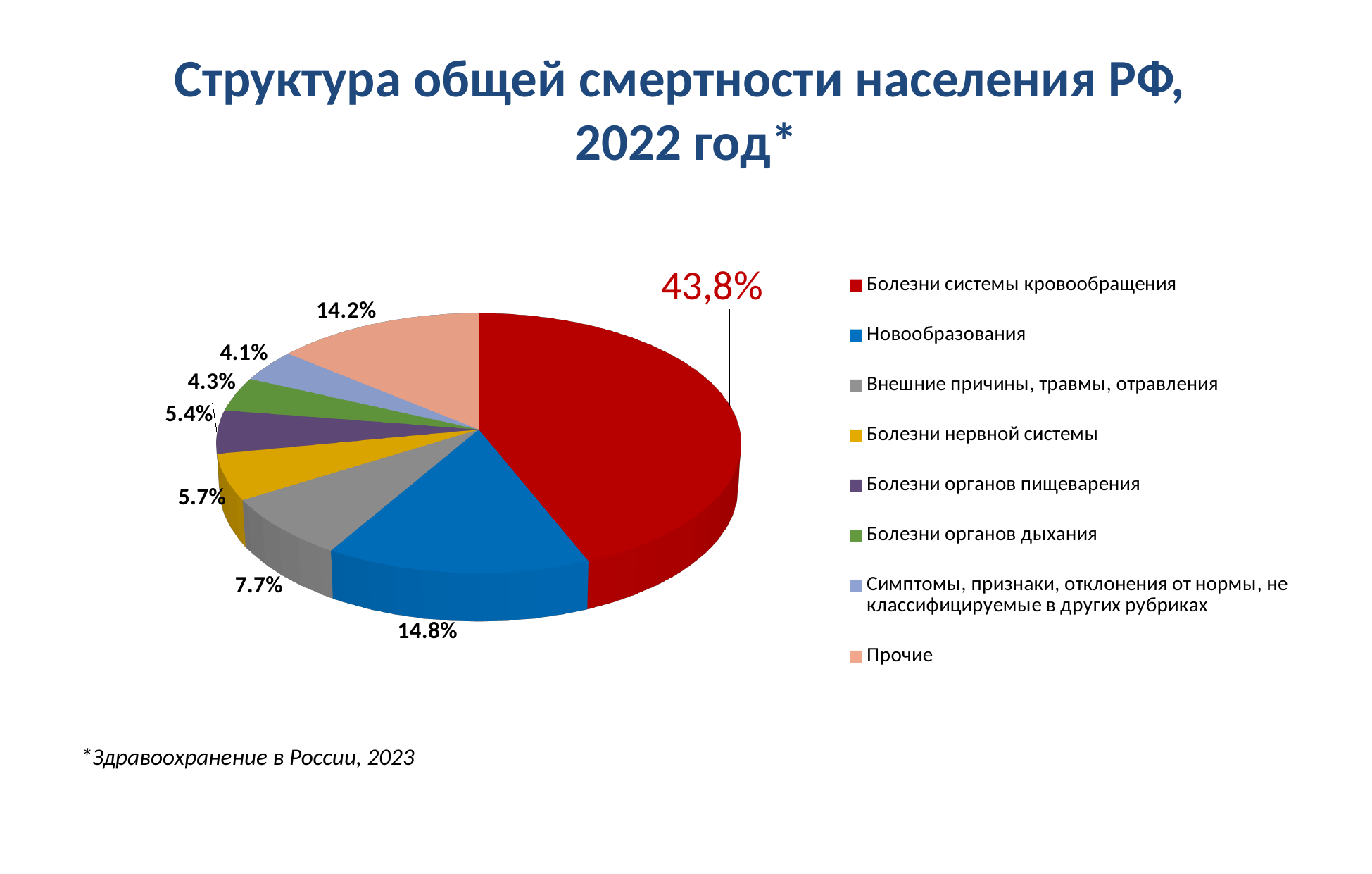
What is the value for Болезни органов дыхания? 4.3% What share of total mortality is attributed to Болезни системы кровообращения? 43,8% How many categories does the legend list? 8 What is the value shown for Новообразования? 14.8% What is the value for Болезни органов пищеварения? 5.4% What is the value for Прочие? 14.2% What is the value for Болезни нервной системы? 5.7% What percentage is shown for Внешние причины, травмы, отравления? 7.7% What is the difference between the shares of Новообразования and Прочие? 0.6% Which category has the largest share of the pie? Болезни системы кровообращения What kind of chart is shown on the slide? Pie chart Which category has the smallest share of the pie? Симптомы, признаки, отклонения от нормы, не классифицируемые в других рубриках